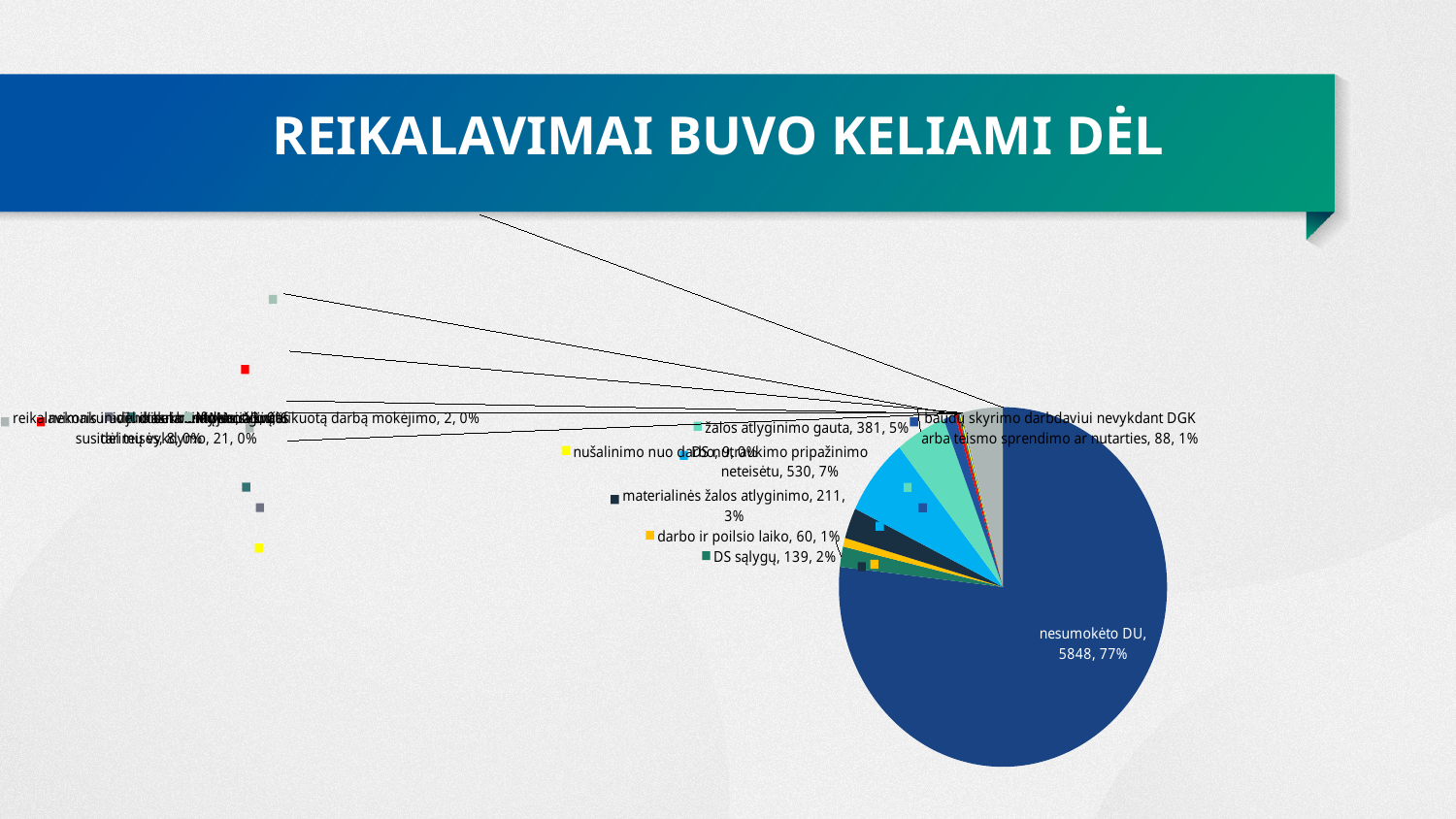
What is the value for 'darbo ir poilsio laiko'? 60 Which category has the largest slice of the pie? nesumokėto DU What is the value for 'nesumokėto DU'? 5848 What is the value for 'materialinės žalos atlyginimo'? 211 What is the value for 'baudų skyrimo darbdaviui nevykdant DGK arba teismo sprendimo ar nutarties'? 88 What is the value for 'DS sąlygų'? 139 Which is larger: 'žalos atlyginimo gauta' or 'materialinės žalos atlyginimo'? žalos atlyginimo gauta What share of the pie does 'nesumokėto DU' represent? 77% What kind of chart is shown on the slide? pie chart What is the difference between the values for 'nesumokėto DU' and 'žalos atlyginimo gauta'? 5467 What is the value for 'žalos atlyginimo gauta'? 381 What is the title of the slide containing the chart? REIKALAVIMAI BUVO KELIAMI DĖL